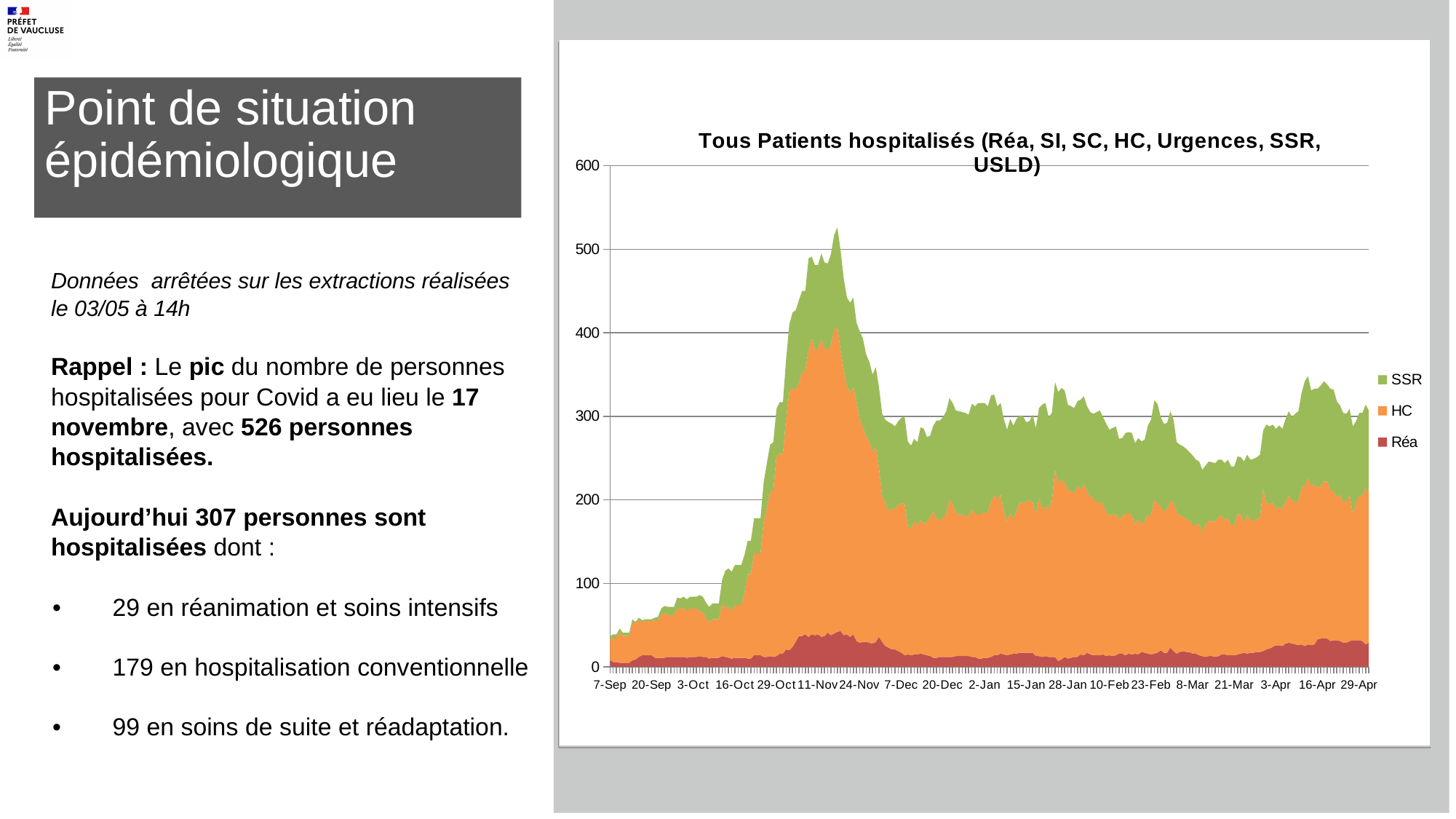
Which colour represents the HC series in the chart? Orange How many series does the chart legend list? 3 Is the stacked total at 7-Sep greater or less than 100? less Is the peak of the stacked total (around mid-November) greater or less than 500? greater Which series occupies the largest band of the stacked area across the chart? HC Is the Réa series ever greater or less than 100 over the whole period? less What are the three series listed in the chart legend? SSR, HC, Réa Does the stacked total rise or fall between 11-Nov and 7-Dec? Fall How many date labels are shown on the x axis? 19 Which series has the smallest values throughout the chart? Réa Does the stacked total rise or fall between 7-Sep and 11-Nov? Rise What kind of chart is shown on the slide? Stacked area chart